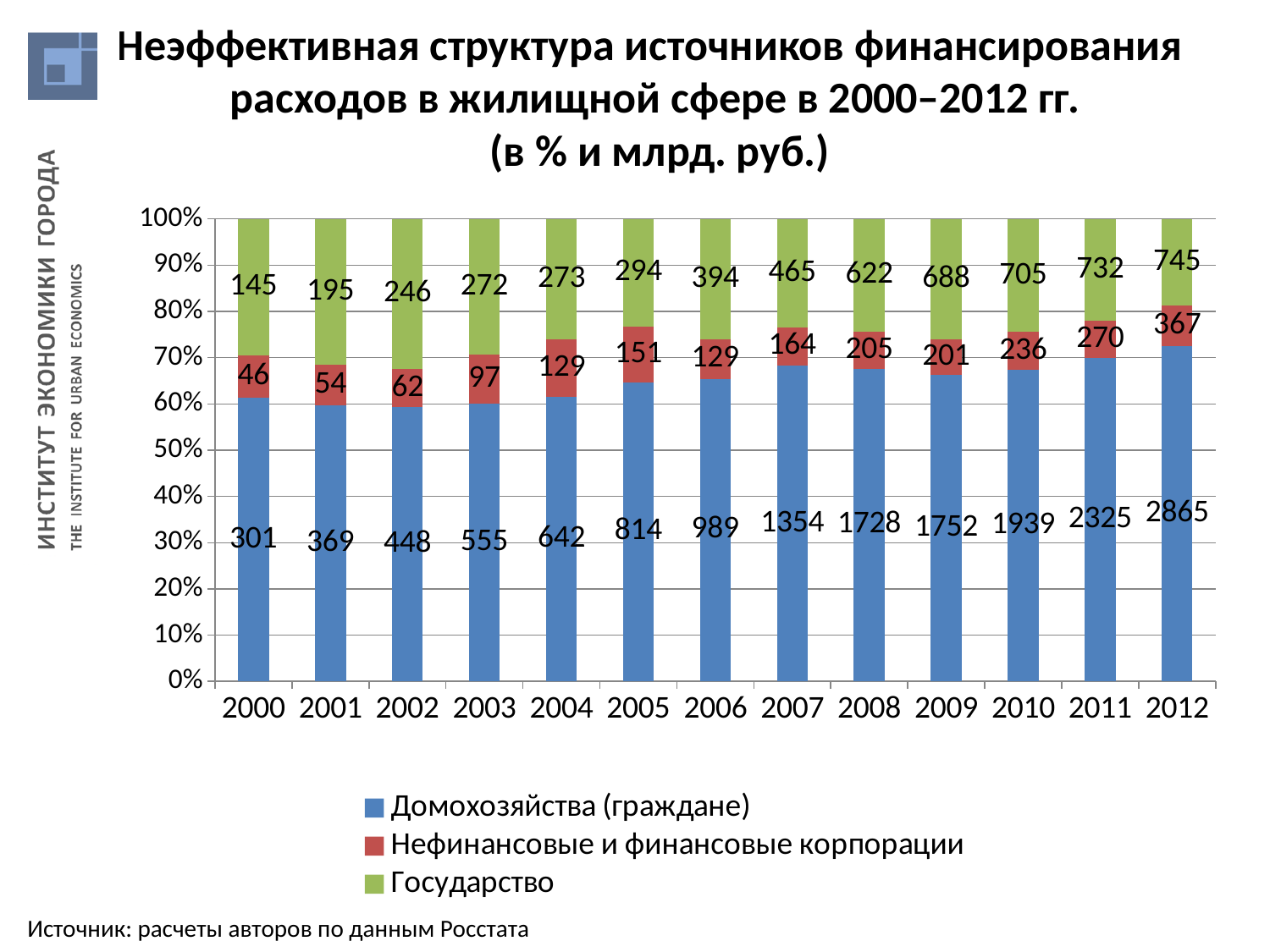
What is the value for Домохозяйства (граждане) in 2012? 2865 How many years are shown on the x axis? 13 What is the difference between the Государство values for 2012 and 2000? 600 What is the value for Государство in 2005? 294 What is the total of the three labelled values for 2000? 492 In which year is the value for Нефинансовые и финансовые корпорации the lowest? 2000 What kind of chart is shown on the slide? Stacked bar chart In which year is the value for Домохозяйства (граждане) the highest? 2012 What is the value for Нефинансовые и финансовые корпорации in 2008? 205 How many series does the legend list? 3 Does the value for Домохозяйства (граждане) rise or fall from 2000 to 2012? Rise Which is larger: the Нефинансовые и финансовые корпорации value in 2005 or in 2006? 2005